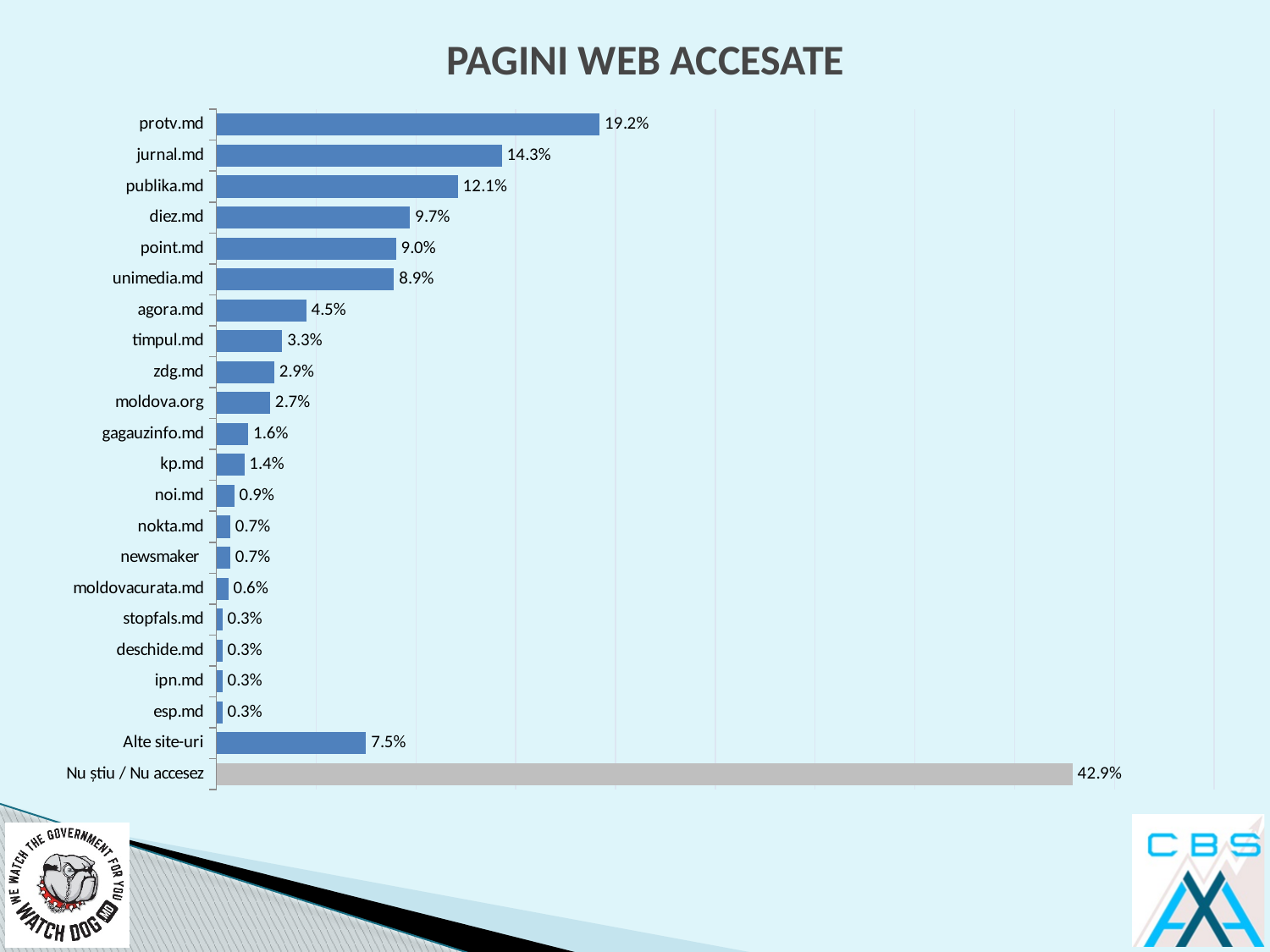
What kind of chart is shown on the slide? bar chart What is the difference between the values for protv.md and jurnal.md? 4.9 percentage points What is the value for unimedia.md? 8.9% What is the value for Nu știu / Nu accesez? 42.9% What is the title of the chart? PAGINI WEB ACCESATE What is the value for protv.md? 19.2% How many categories are shown in the chart? 22 Which website (excluding Alte site-uri and Nu știu / Nu accesez) has the highest value? protv.md What is the value for Alte site-uri? 7.5% What is the difference between the values for publika.md and diez.md? 2.4 percentage points Which category has the highest value in the chart? Nu știu / Nu accesez Which has a larger value, agora.md or timpul.md? agora.md